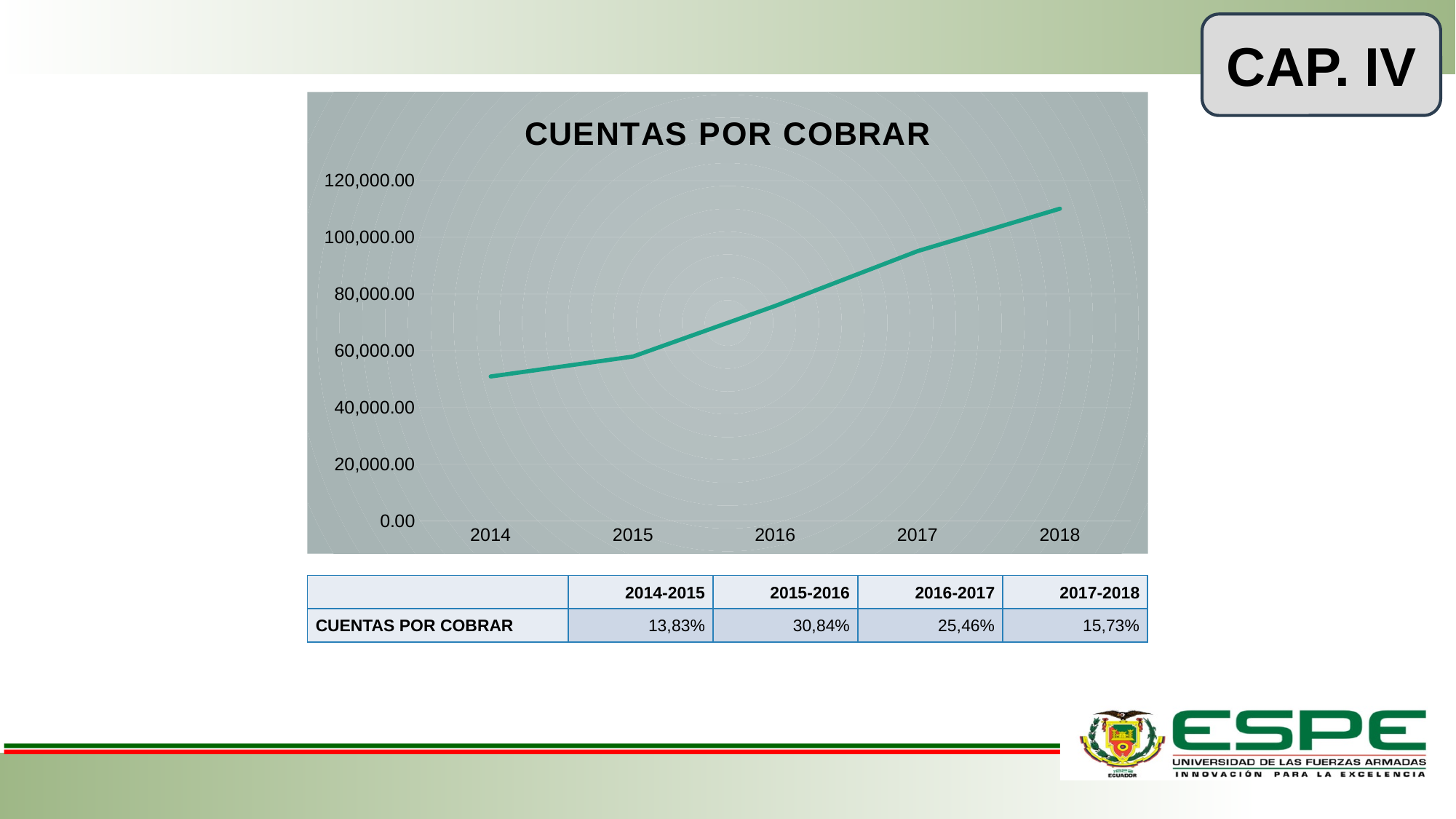
Which year has the larger value, 2015 or 2017? 2017 Which year has the lowest value in the chart? 2014 What is the highest tick value shown on the y axis of the chart? 120,000.00 Is the value for 2017 greater or less than 80,000.00? greater Which year has the highest value in the chart? 2018 Is the value for 2016 greater or less than 60,000.00? greater What kind of chart is shown on the slide? line chart Is the value for 2018 greater or less than 100,000.00? greater What is the title of the chart? CUENTAS POR COBRAR Do the values in the chart rise or fall from 2014 to 2018? rise How many years are plotted on the x axis of the chart? 5